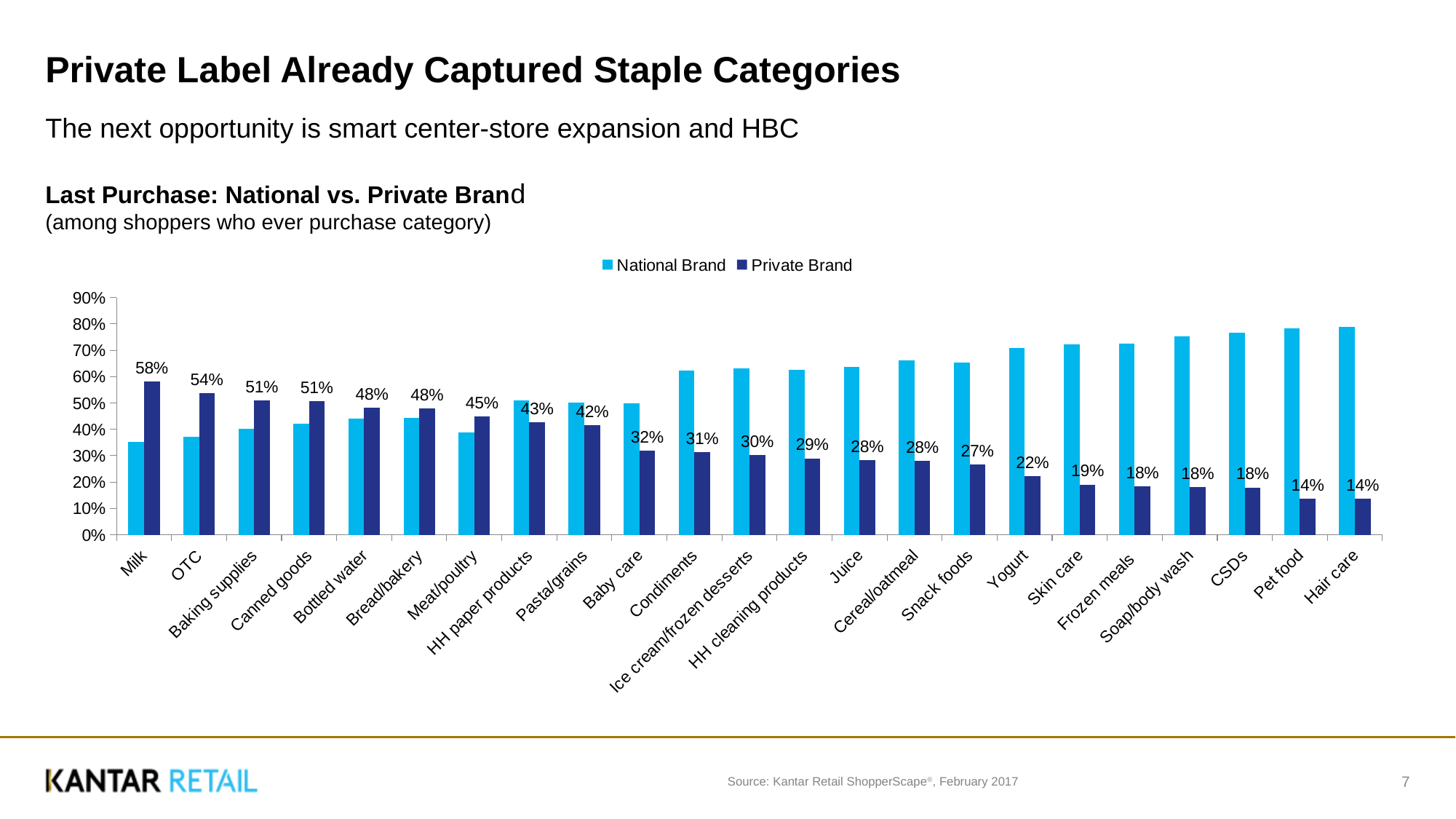
What is the Private Brand value for Yogurt? 22% How many categories are shown on the x axis? 23 How many series does the legend list? 2 Do the Private Brand values rise or fall from left to right along the x axis? fall What is the Private Brand value for Milk? 58% What is the Private Brand value for Baby care? 32% Which is larger for Milk: the National Brand bar or the Private Brand bar? Private Brand What is the difference between the Private Brand values for Milk and OTC? 4% Which category has the highest Private Brand value? Milk Which is larger for Hair care: the National Brand bar or the Private Brand bar? National Brand Is the National Brand value for Hair care greater or less than 70%? greater Is the National Brand value for Milk greater or less than 40%? less